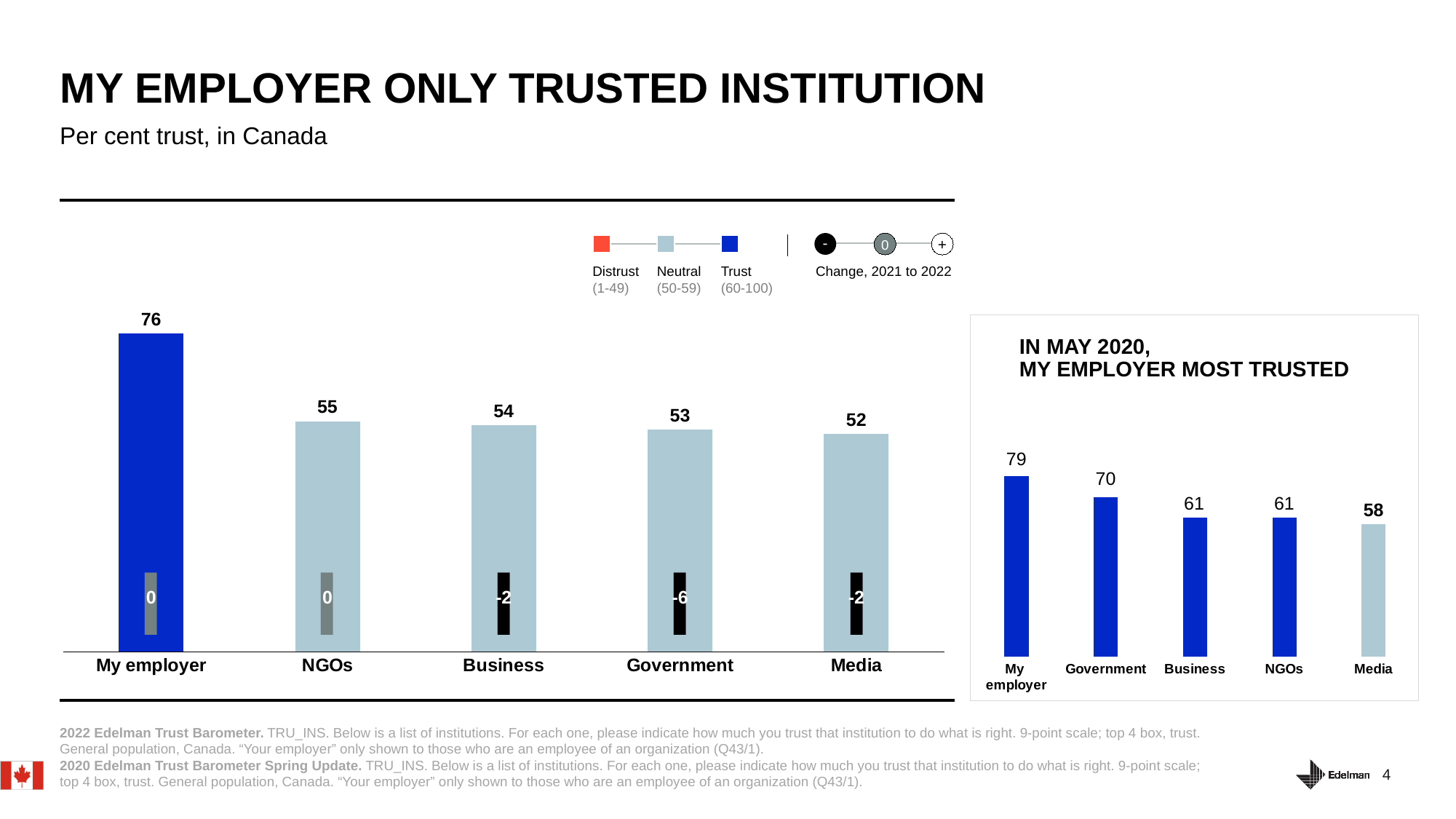
In the main chart on the left, what is the per cent trust value for Government? 53 What kind of chart is the main chart on the left? Bar chart In the main chart on the left, which institution has the lowest trust value? Media In the 'In May 2020, My employer most trusted' chart on the right, what is the value for Media? 58 In the main chart on the left, what is the difference between the trust values for My employer and NGOs? 21 In the main chart on the left, what is the per cent trust value for My employer? 76 In the main chart on the left, how many institutions are shown? 5 In the 'In May 2020, My employer most trusted' chart on the right, which institution has the highest value? My employer In the 'In May 2020, My employer most trusted' chart on the right, is the value for Business larger or smaller than the value for Government? smaller In the main chart on the left, what is the change from 2021 to 2022 shown for Government? -6 In the 'In May 2020, My employer most trusted' chart on the right, what is the value for Government? 70 In the main chart on the left, which institution has the highest trust value? My employer